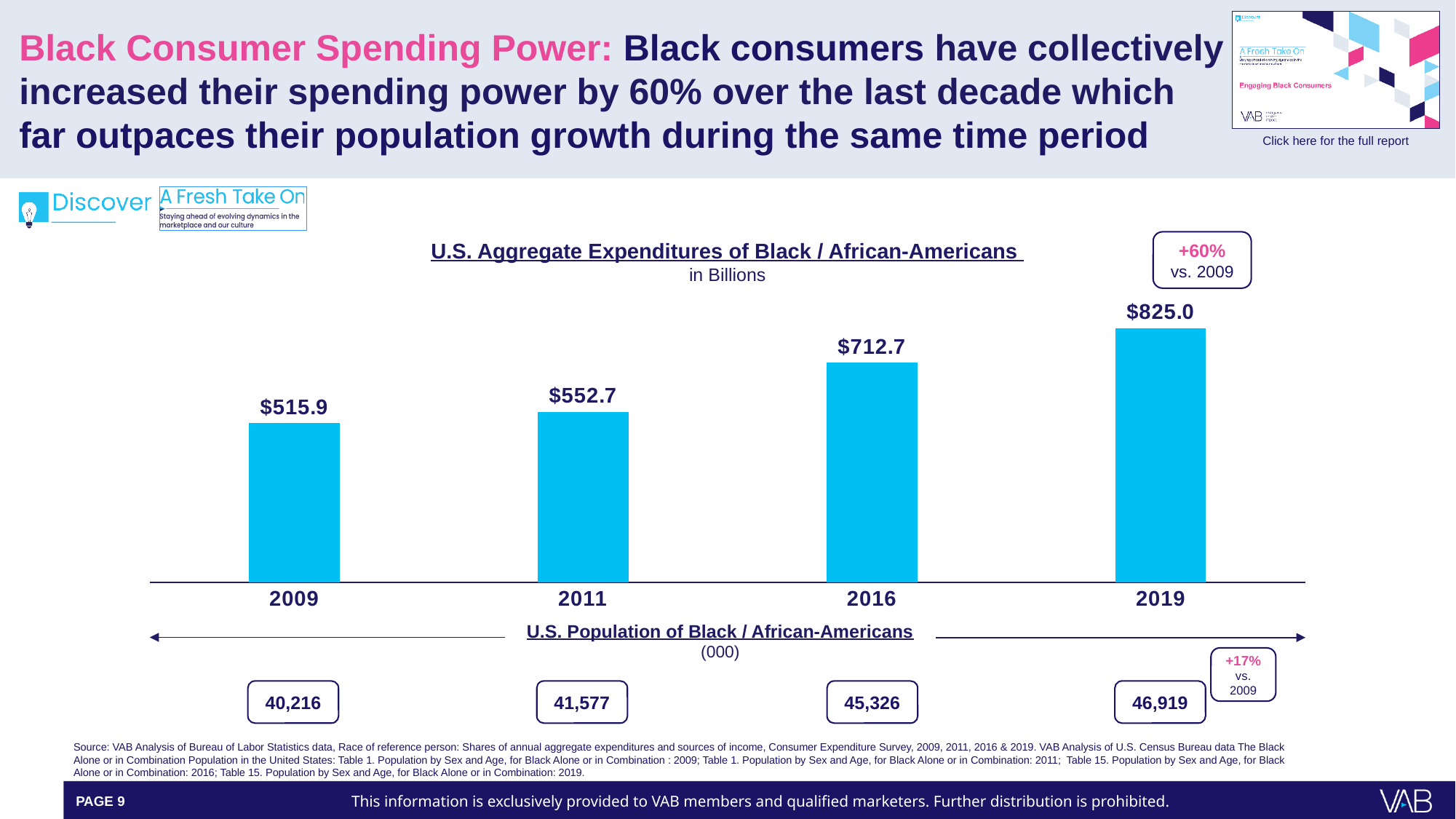
What is the difference between the aggregate expenditure in 2019 and in 2009? $309.1 Which year has the larger aggregate expenditure, 2011 or 2016? 2016 Do the aggregate expenditure values rise or fall from 2009 to 2019? Rise What unit is the aggregate expenditures chart expressed in, according to its subtitle? Billions What is the U.S. aggregate expenditure of Black / African-Americans shown for 2019? $825.0 What kind of chart is used to show U.S. aggregate expenditures of Black / African-Americans? Bar chart What is the U.S. aggregate expenditure of Black / African-Americans shown for 2009? $515.9 How many years are plotted in the aggregate expenditures chart? 4 Which year has the lowest aggregate expenditure in the chart? 2009 Which year has the highest aggregate expenditure in the chart? 2019 What is the U.S. aggregate expenditure of Black / African-Americans shown for 2016? $712.7 What is the difference between the aggregate expenditure in 2016 and in 2011? $160.0